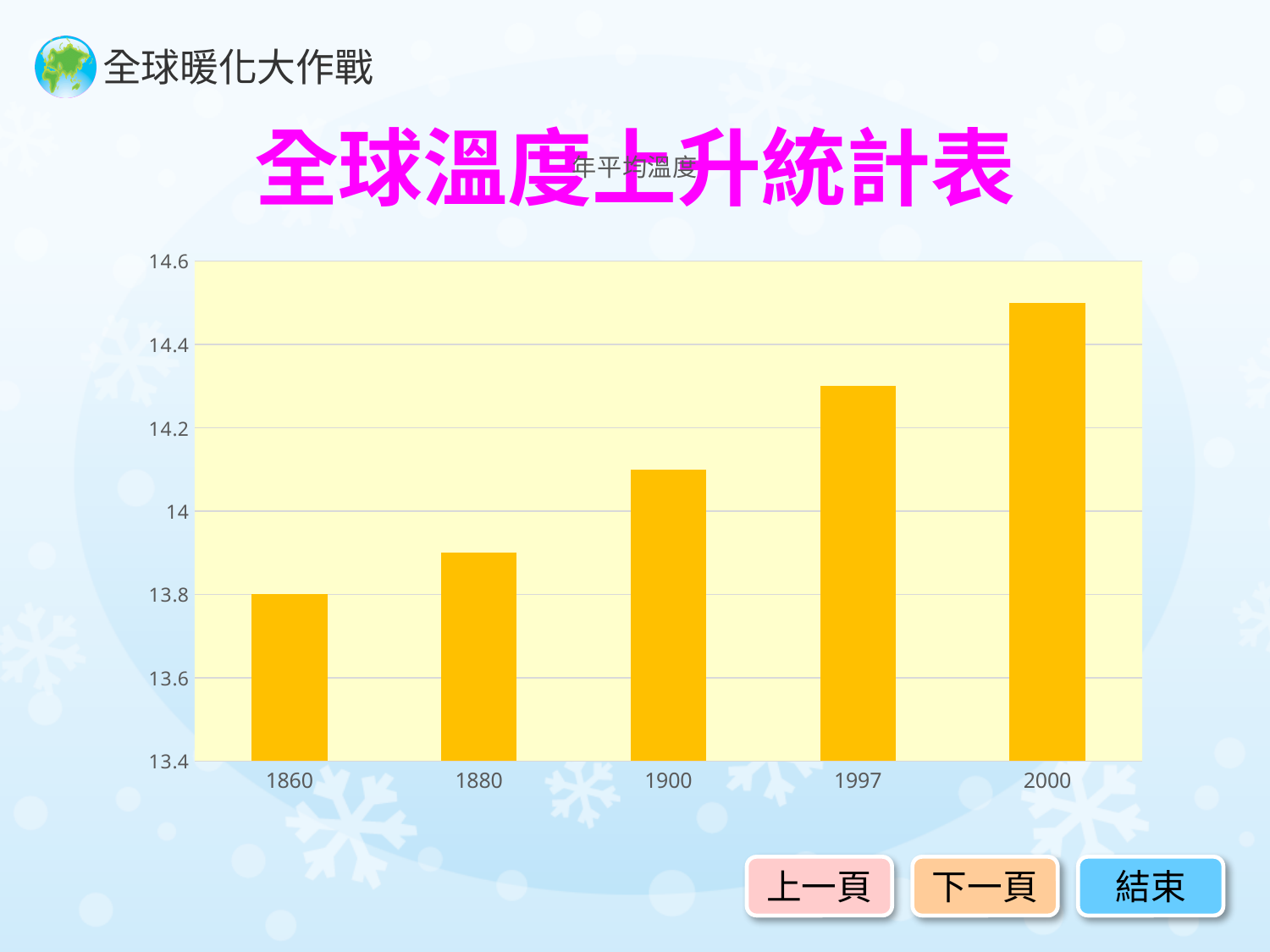
Is the value for 2000 greater or less than 14.4? greater Do the values rise or fall from 1860 to 2000 along the x axis? rise Is the value for 1900 greater or less than 14? greater Is the value for 1880 greater or less than 14? less How many years are shown on the x axis of the chart? 5 Which year has the lowest bar in the chart? 1860 What is the title of the slide above the chart? 全球溫度上升統計表 Which year has the highest bar in the chart? 2000 What is the value for 1860 in the chart? 13.8 What kind of chart is shown on the slide? bar chart Which year has the larger value, 1880 or 1900? 1900